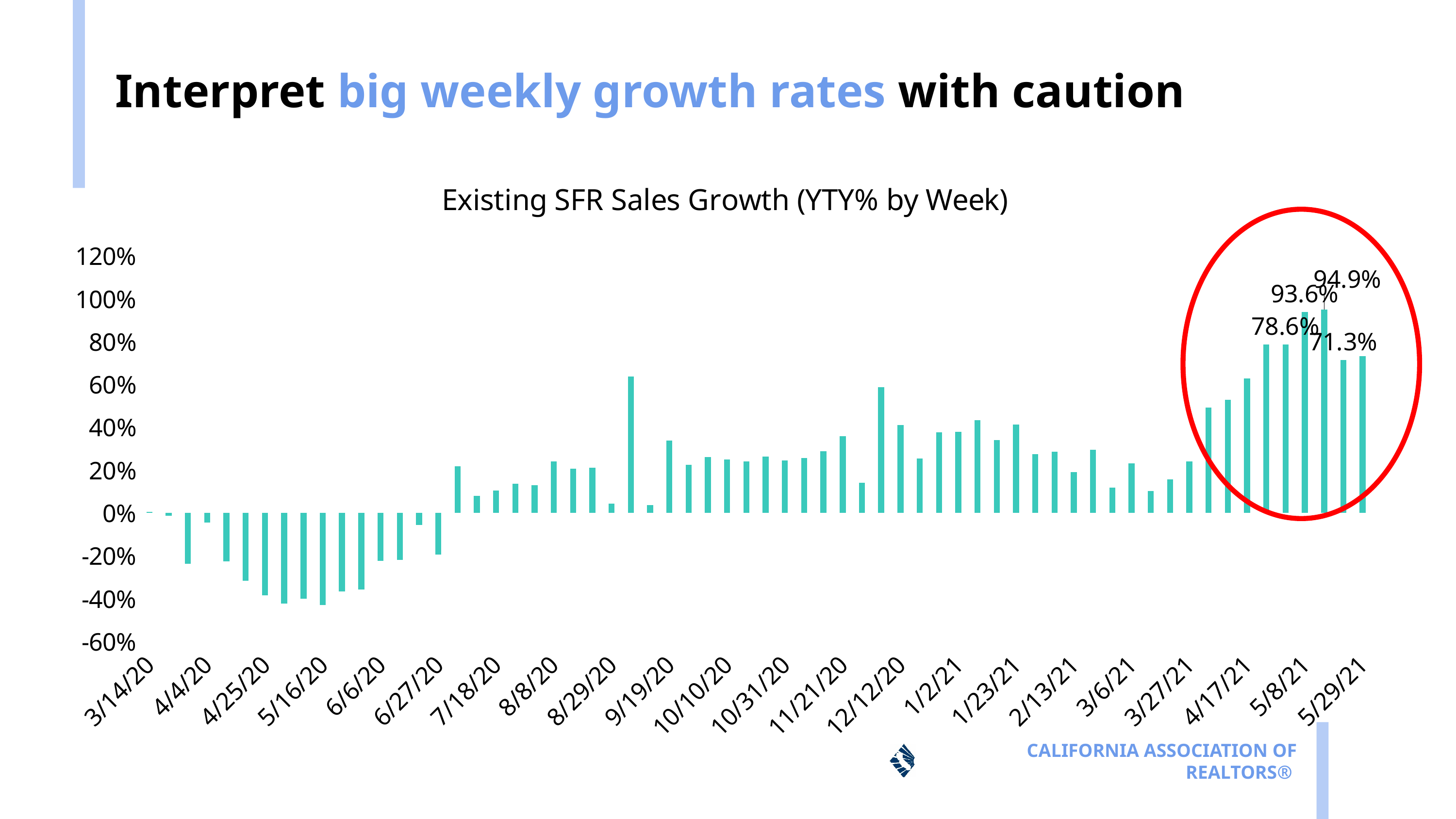
Do the values generally rise or fall from 3/27/21 to 5/8/21? rise What is the title of the chart? Existing SFR Sales Growth (YTY% by Week) Is the value for 4/25/20 greater or less than 0%? less Is the value for 5/29/21 greater or less than 60%? greater What is the difference between the labelled values 94.9% and 71.3%? 23.6 percentage points What is the lowest of the four data-labelled values inside the red circle? 71.3% Is the value for 3/14/20 greater or less than 20%? less How many data labels are printed on the bars inside the red circle? 4 What kind of chart is shown on the slide? Bar chart Which is larger among the labelled values: 93.6% or 78.6%? 93.6% What is the difference between the labelled values 93.6% and 78.6%? 15.0 percentage points What is the highest value shown on the chart? 94.9%